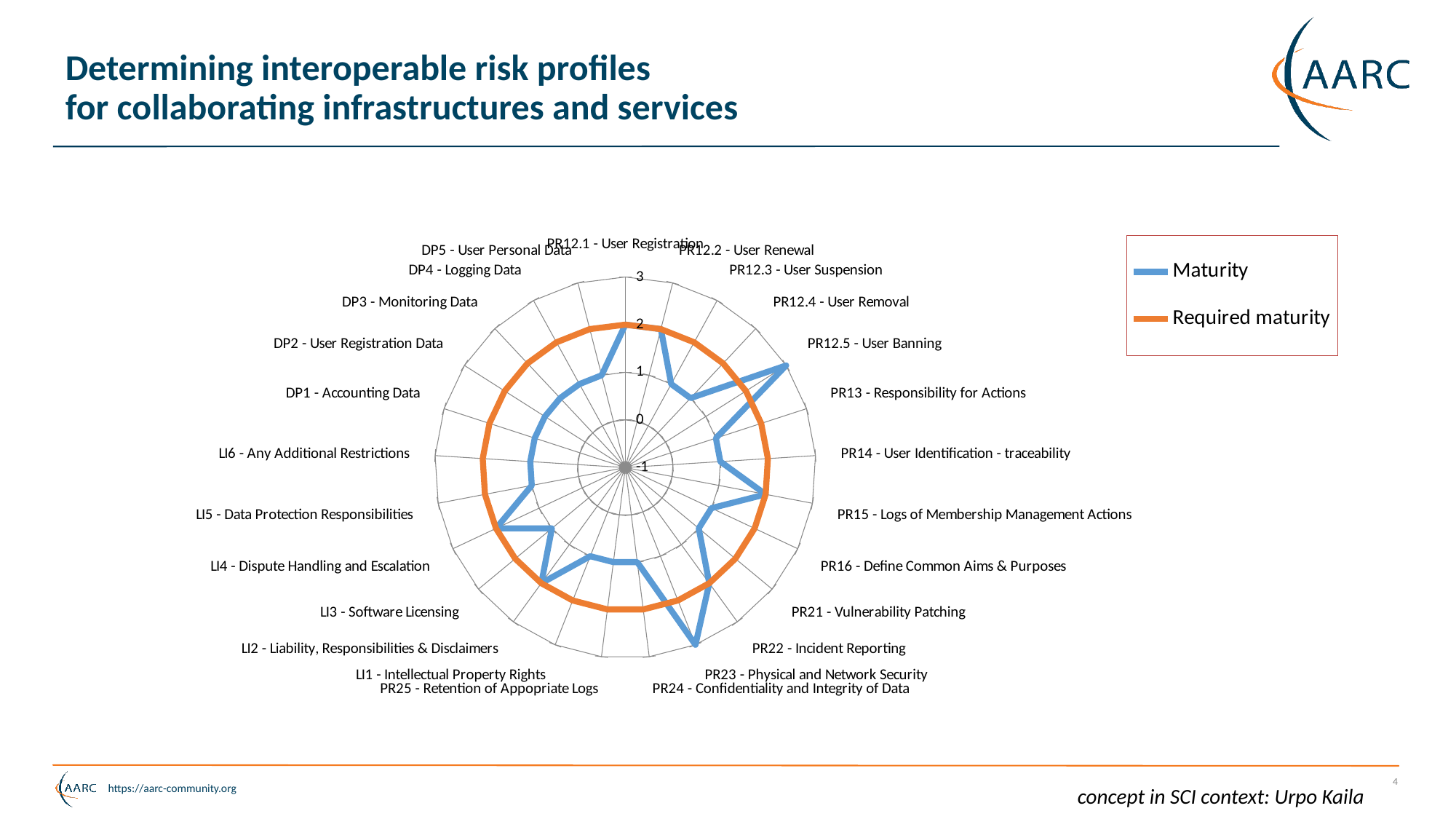
What are the two series named in the legend? Maturity and Required maturity What is the Maturity value for PR12.1 - User Registration? 2 How many series does the legend list? 2 What kind of chart is shown on the slide? Radar chart Is the Maturity value for PR12.3 - User Suspension greater or less than 2? less What is the Maturity value for PR12.5 - User Banning? 3 What is the difference between Maturity and Required maturity for PR12.5 - User Banning? 1 Is the Maturity value for PR13 - Responsibility for Actions greater or less than 2? less What is the Required maturity value for PR12.5 - User Banning? 2 How many categories are plotted around the radar chart? 25 What is the highest value shown on the radar chart's axis scale? 3 For PR12.5 - User Banning, which is larger: Maturity or Required maturity? Maturity